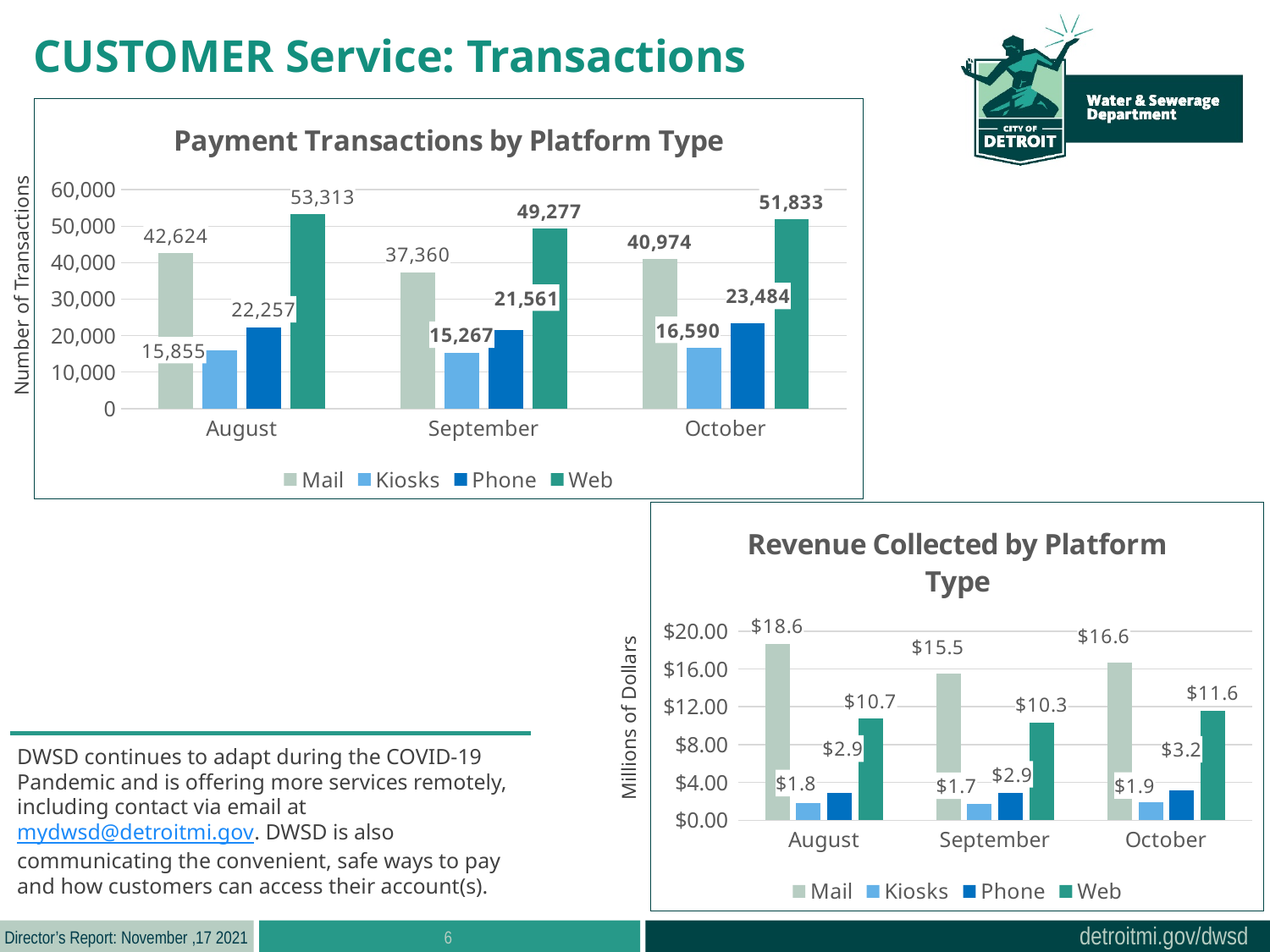
In the Revenue Collected by Platform Type chart, is Phone revenue in October larger or smaller than Phone revenue in August? larger In the Payment Transactions by Platform Type chart, how many Web transactions were there in August? 53,313 In the Payment Transactions by Platform Type chart, do Phone transactions rise or fall from September to October? rise In the Revenue Collected by Platform Type chart, how much revenue was collected by Web in October? $11.6 In the Payment Transactions by Platform Type chart, what is the difference between Web and Mail transactions in September? 11,917 In the Payment Transactions by Platform Type chart, how many Kiosks transactions were there in September? 15,267 In the Payment Transactions by Platform Type chart, which platform had the fewest transactions in August? Kiosks In the Payment Transactions by Platform Type chart, how many series does the legend list? 4 What kind of chart is the Revenue Collected by Platform Type chart? bar chart In the Revenue Collected by Platform Type chart, which platform collected the least revenue in September? Kiosks In the Payment Transactions by Platform Type chart, which platform had the most transactions in October? Web In the Revenue Collected by Platform Type chart, how much revenue was collected by Mail in August? $18.6